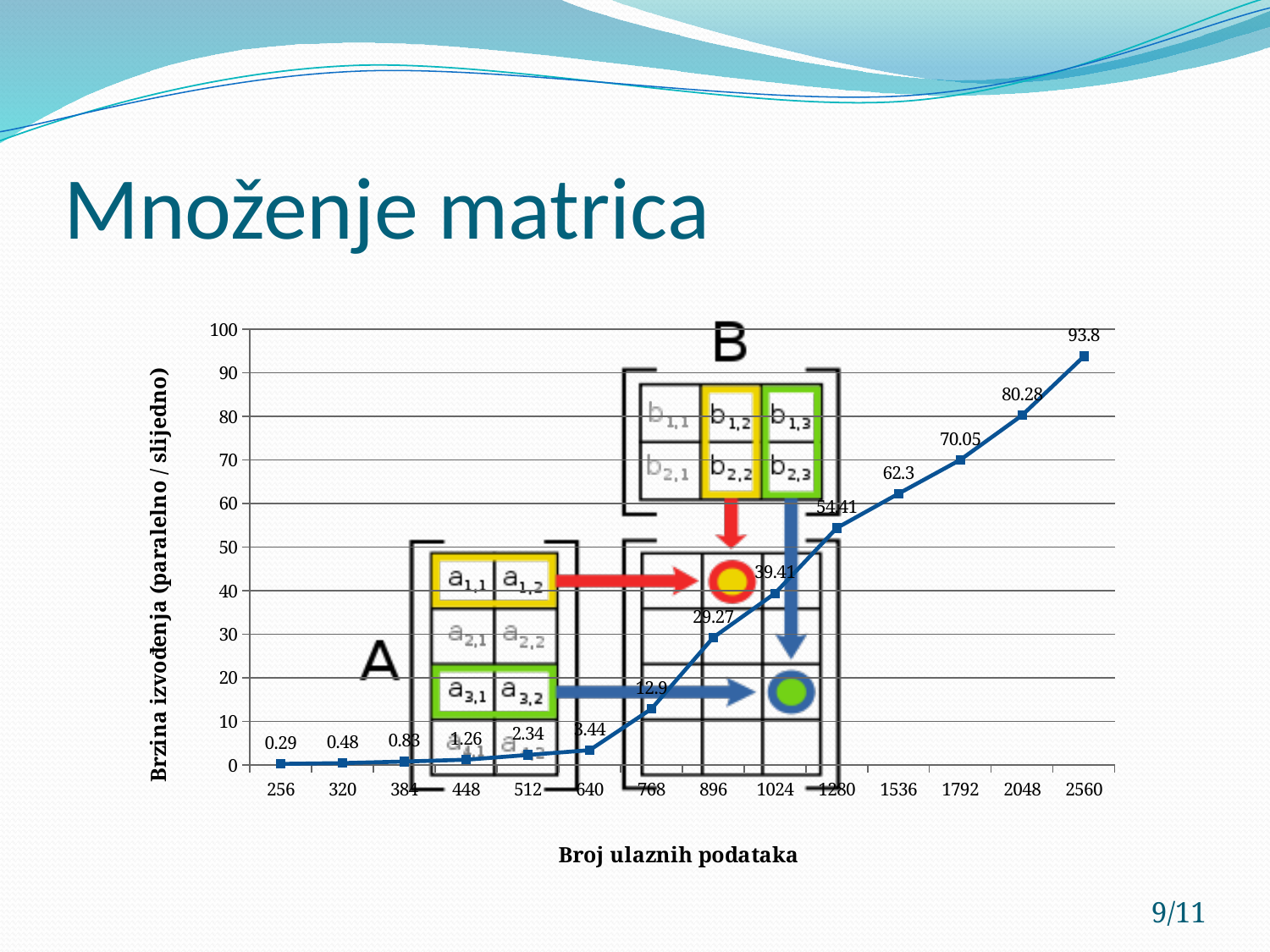
What is the value for 896 on the chart? 29.27 What is the difference between the values for 2048 and 1536? 17.98 Do the values rise or fall as the number of input data increases along the x axis? rise What is the value for 256 on the chart? 0.29 Which input size has the lowest value on the chart? 256 What kind of chart is shown on the slide? line chart What is the value for 1792 on the chart? 70.05 What is the value for 2560 on the chart? 93.8 Is the value for 1280 greater or less than 50? greater How many data points are plotted on the chart? 14 Which is larger, the value for 768 or the value for 1024? 1024 Which input size has the highest value on the chart? 2560